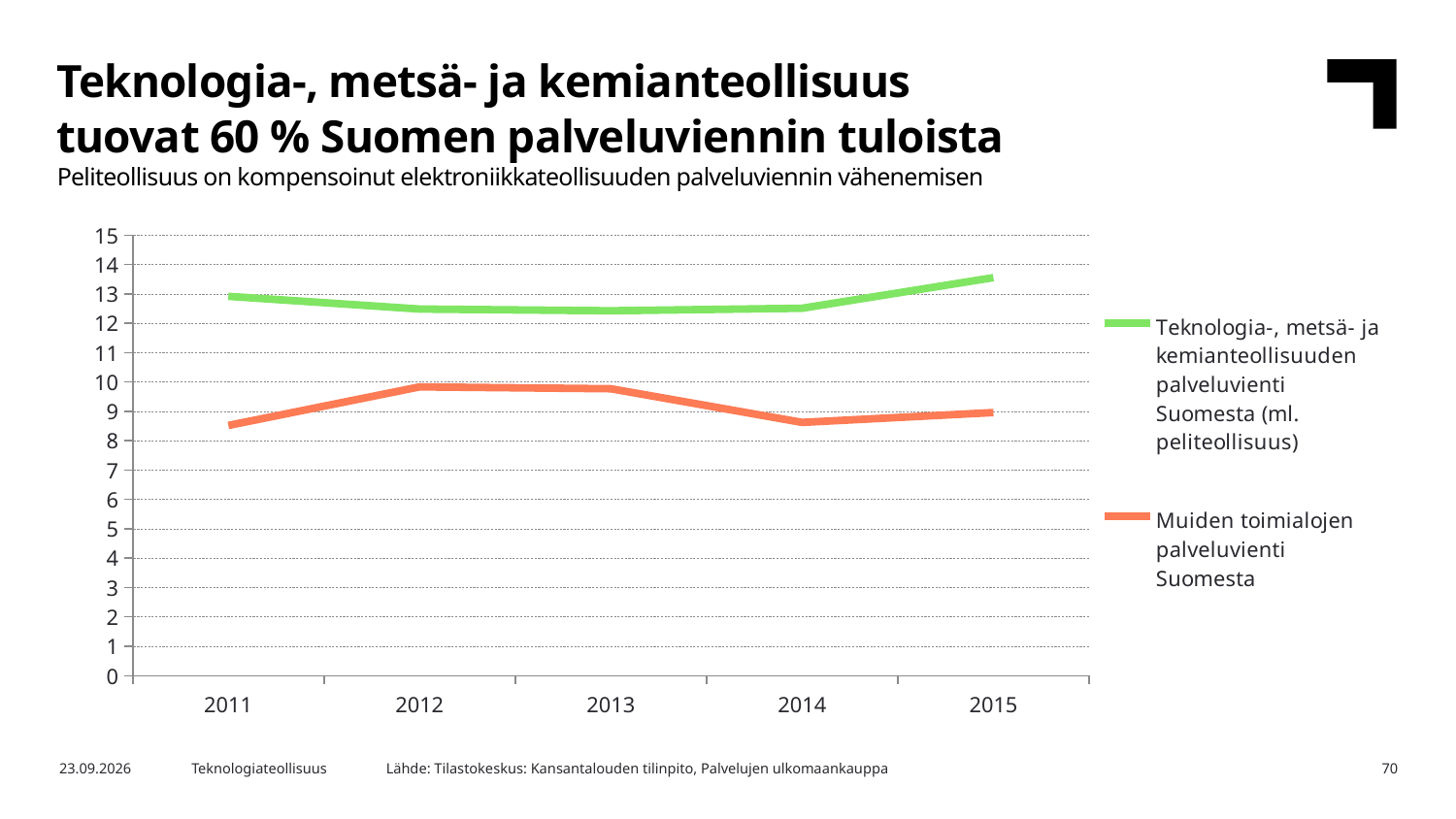
Is the 2014 value for 'Teknologia-, metsä- ja kemianteollisuuden palveluvienti Suomesta (ml. peliteollisuus)' greater or less than 12? greater Does the 'Teknologia-, metsä- ja kemianteollisuuden palveluvienti Suomesta (ml. peliteollisuus)' series rise or fall from 2014 to 2015? rise Is the 2012 value for 'Muiden toimialojen palveluvienti Suomesta' greater or less than 10? less Is the 2011 value for 'Muiden toimialojen palveluvienti Suomesta' greater or less than 9? less Does the 'Muiden toimialojen palveluvienti Suomesta' series rise or fall from 2013 to 2014? fall In which year does the 'Teknologia-, metsä- ja kemianteollisuuden palveluvienti Suomesta (ml. peliteollisuus)' series reach its highest value? 2015 What colour is the line for 'Muiden toimialojen palveluvienti Suomesta' in the chart? orange What kind of chart is shown on the slide? line chart How many years are shown on the x axis of the chart? 5 How many series does the chart's legend list? 2 In 2013, which series has the higher value: 'Teknologia-, metsä- ja kemianteollisuuden palveluvienti Suomesta (ml. peliteollisuus)' or 'Muiden toimialojen palveluvienti Suomesta'? Teknologia-, metsä- ja kemianteollisuuden palveluvienti Suomesta (ml. peliteollisuus)